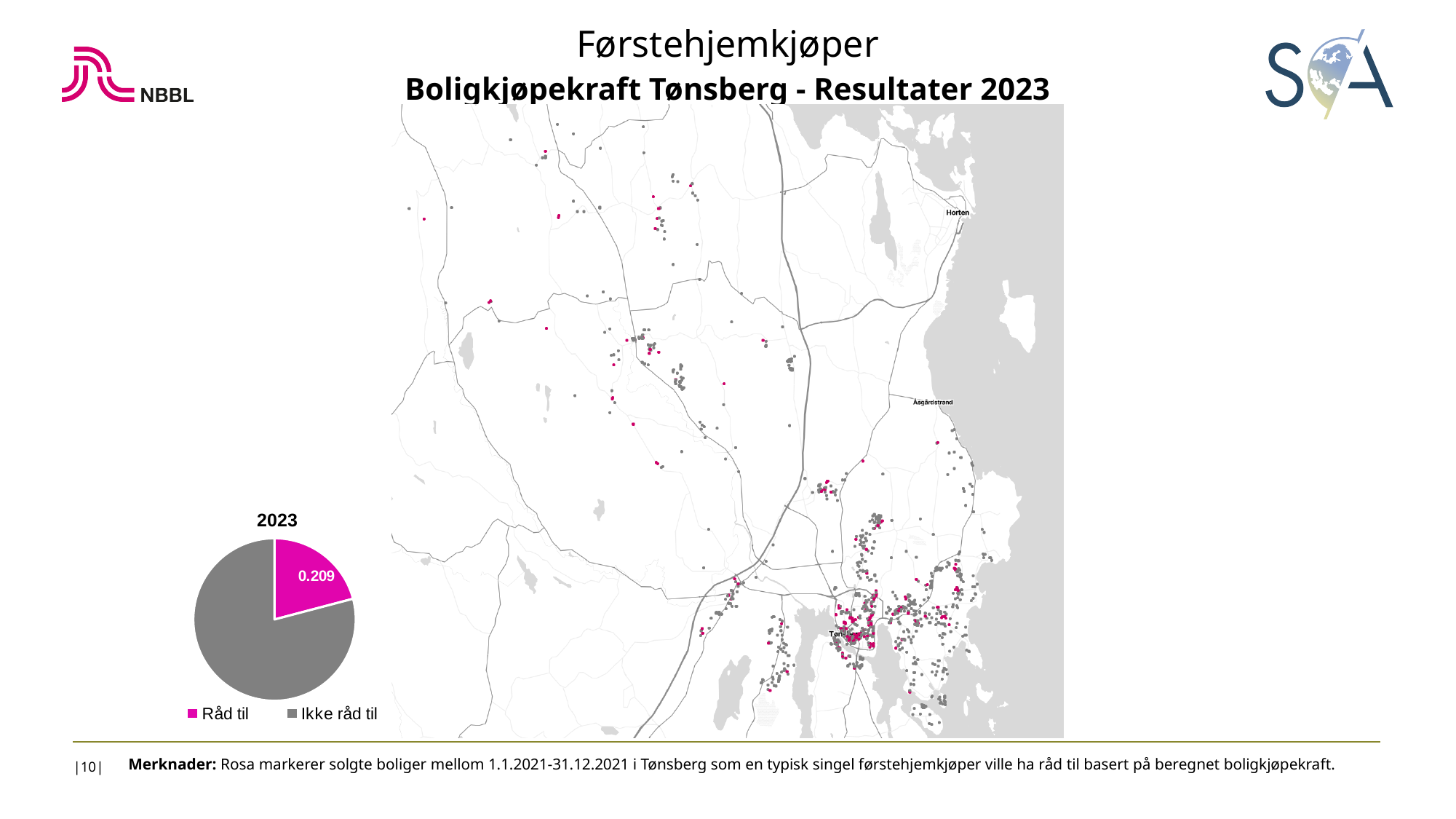
How many slices does the pie chart have? 2 In the pie chart, what value is shown for Råd til? 0.209 What kind of chart is shown on the left of the slide? pie chart Which slice of the pie chart is the smallest? Råd til How many entries does the pie chart's legend list? 2 What is the title of the pie chart? 2023 In the pie chart, which is larger: Råd til or Ikke råd til? Ikke råd til What colour is the Råd til slice in the pie chart? pink Which slice of the pie chart is the largest? Ikke råd til